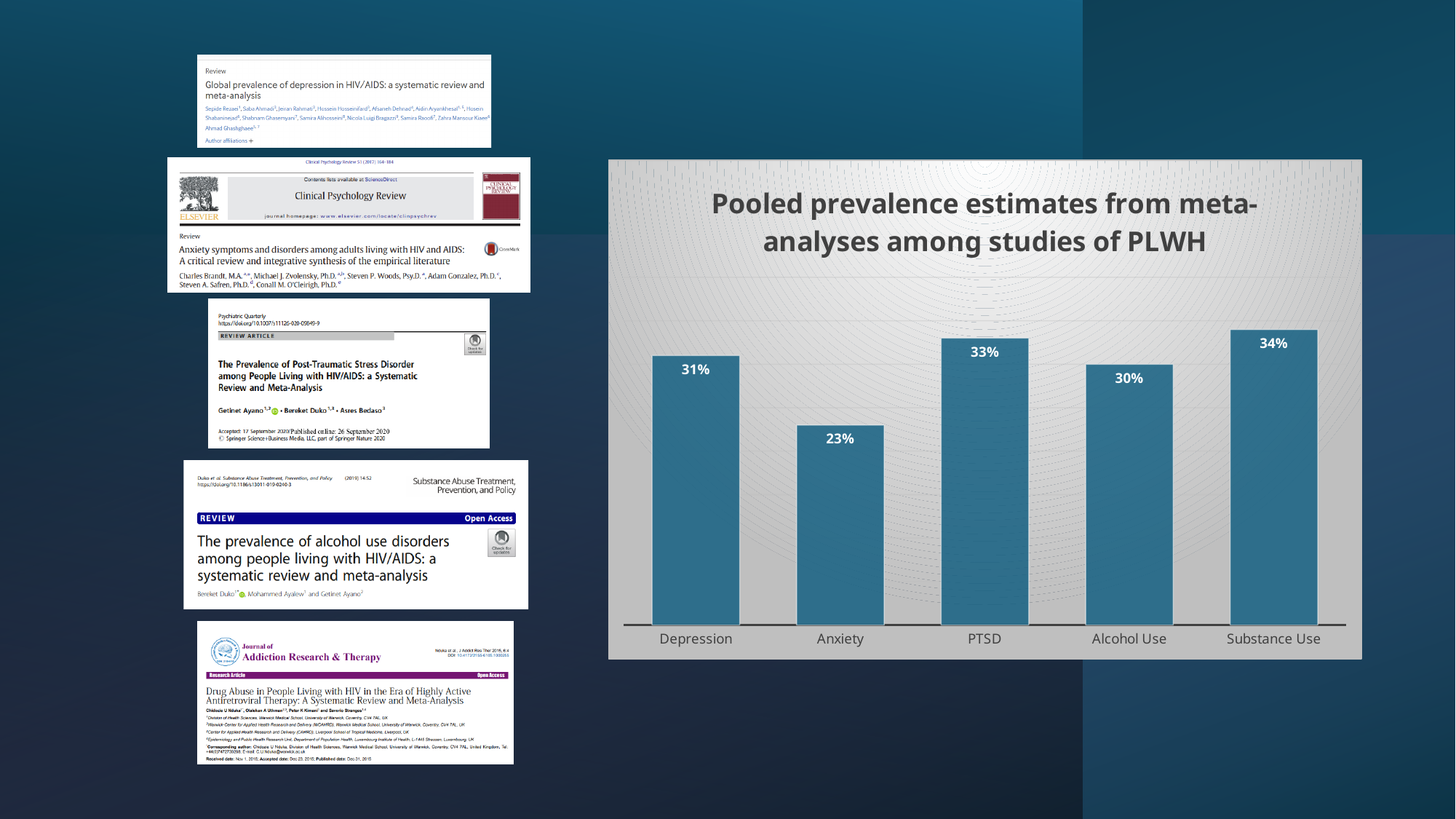
What is the difference between the pooled prevalence estimates for PTSD and Alcohol Use? 3% What kind of chart is shown on the slide? Bar chart Which category has the lowest pooled prevalence estimate? Anxiety What is the title of the chart? Pooled prevalence estimates from meta-analyses among studies of PLWH How many categories are shown in the chart? 5 Which category has the highest pooled prevalence estimate? Substance Use What is the pooled prevalence estimate for Depression? 31% What is the pooled prevalence estimate for Alcohol Use? 30% What is the pooled prevalence estimate for PTSD? 33% What is the pooled prevalence estimate for Anxiety? 23% What is the difference between the pooled prevalence estimates for Substance Use and Anxiety? 11% Which has a higher pooled prevalence estimate, Depression or Alcohol Use? Depression